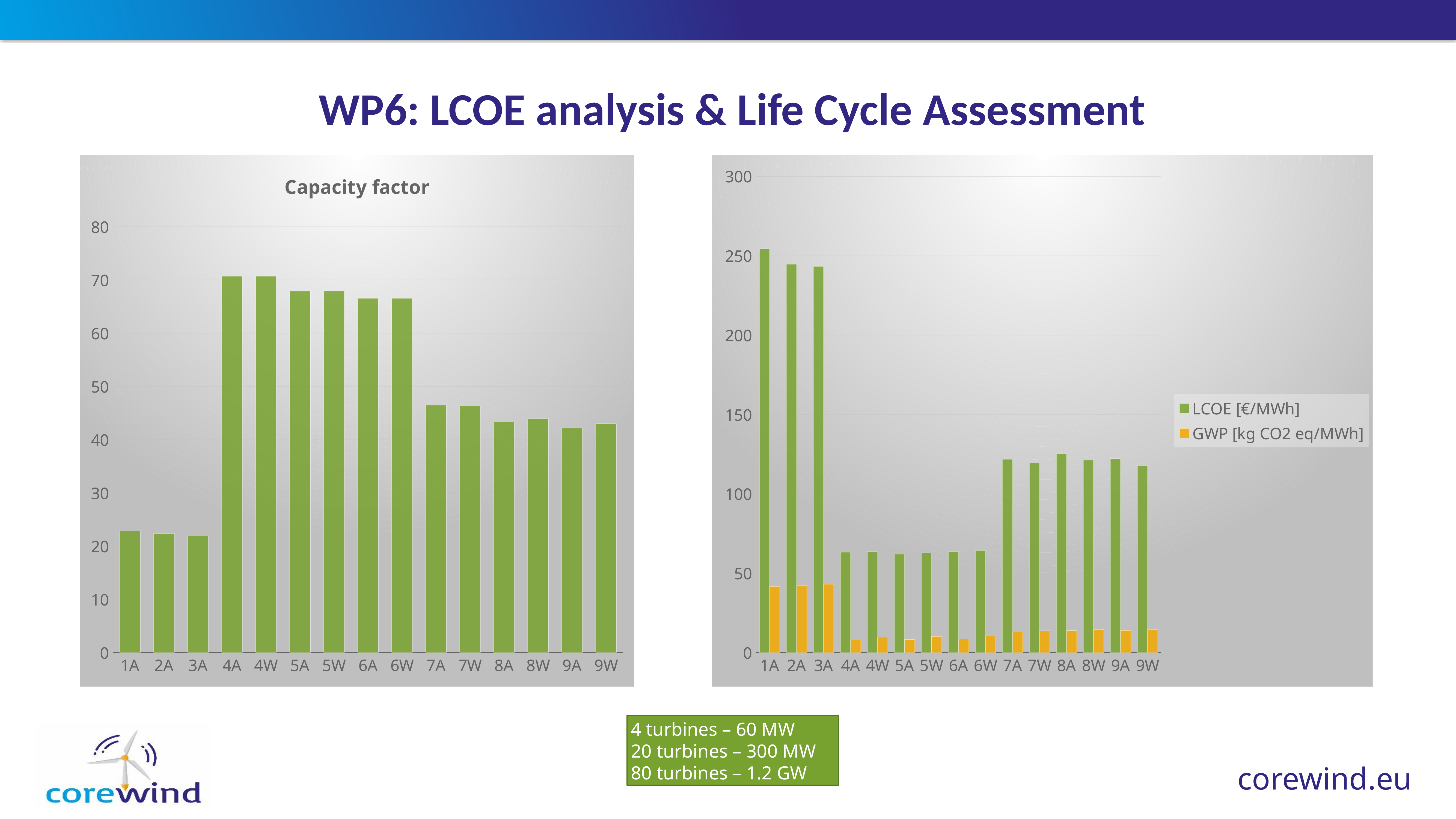
In the Capacity factor chart, is the value for 7A greater or less than 50? less In the Capacity factor chart, which is larger, the value for 1A or the value for 9W? 9W In the right-hand chart, is the GWP [kg CO2 eq/MWh] value for 1A greater or less than 50? less How many series does the legend of the right-hand chart list? 2 In the Capacity factor chart, is the value for 4A greater or less than 60? greater What kind of chart is the Capacity factor chart on the left? bar chart How many categories are shown on the x axis of the Capacity factor chart? 15 What are the two legend entries of the right-hand chart? LCOE [€/MWh] and GWP [kg CO2 eq/MWh] In the Capacity factor chart, which is larger, the value for 4A or the value for 7A? 4A In the right-hand chart, which category has the highest LCOE [€/MWh] value? 1A